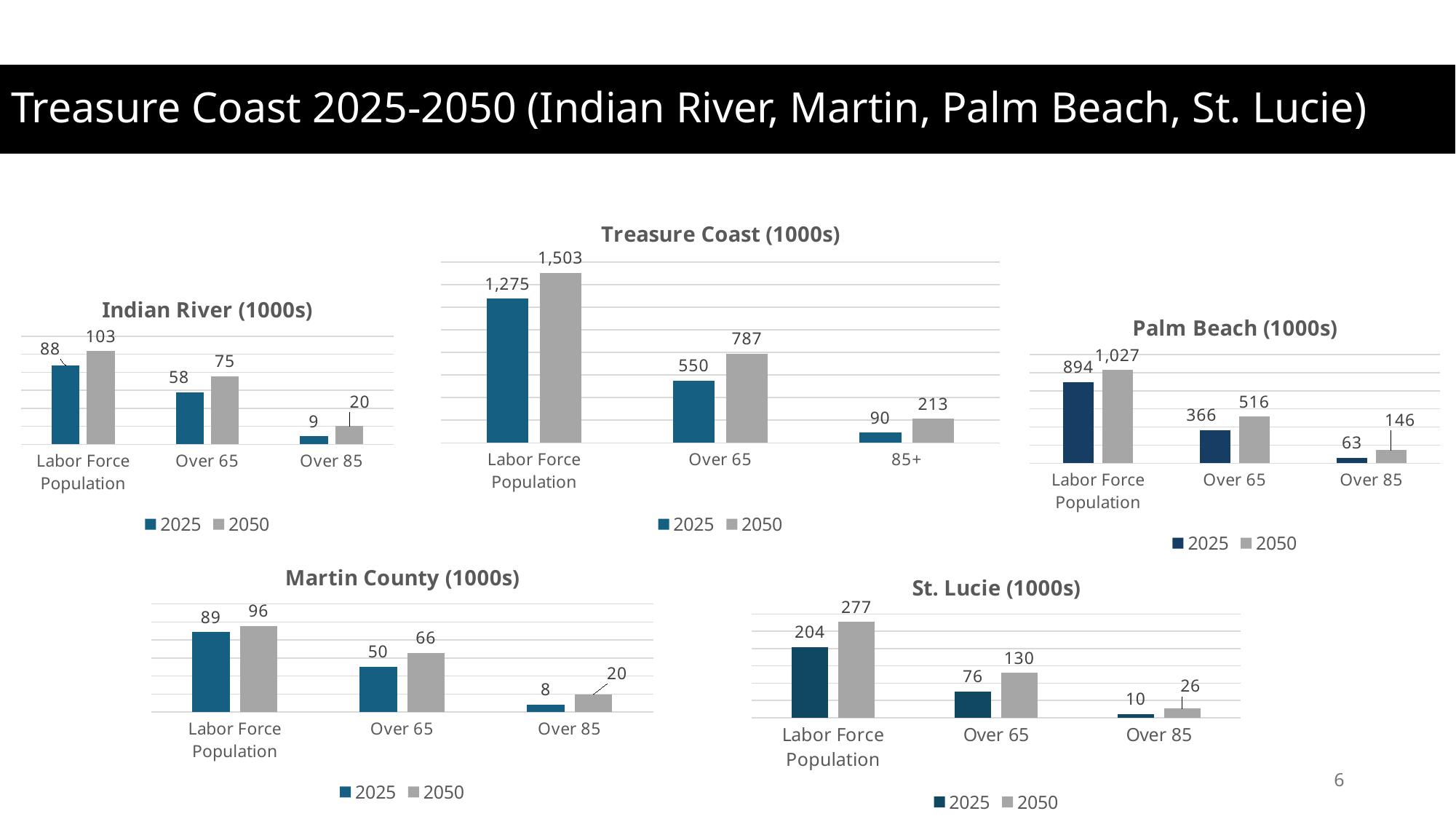
In the Treasure Coast (1000s) chart, what is the 2050 value for Labor Force Population? 1,503 In the Palm Beach (1000s) chart, what is the difference between the 2050 and 2025 values for Labor Force Population? 133 In the St. Lucie (1000s) chart, what is the 2050 value for Over 85? 26 How many categories are shown on the x axis of the Martin County (1000s) chart? 3 In the Martin County (1000s) chart, which category has the lowest 2025 value? Over 85 What type of chart is the Treasure Coast (1000s) chart? Bar chart In the Palm Beach (1000s) chart, what is the 2025 value for Over 65? 366 How many charts are shown on the slide? 5 In the Treasure Coast (1000s) chart, what is the difference between the 2050 and 2025 values for Over 65? 237 In the Indian River (1000s) chart, what is the 2025 value for Over 85? 9 How many series does the legend of the Indian River (1000s) chart list? 2 In the St. Lucie (1000s) chart, which is larger: the 2050 value for Over 65 or the 2025 value for Labor Force Population? 2025 Labor Force Population